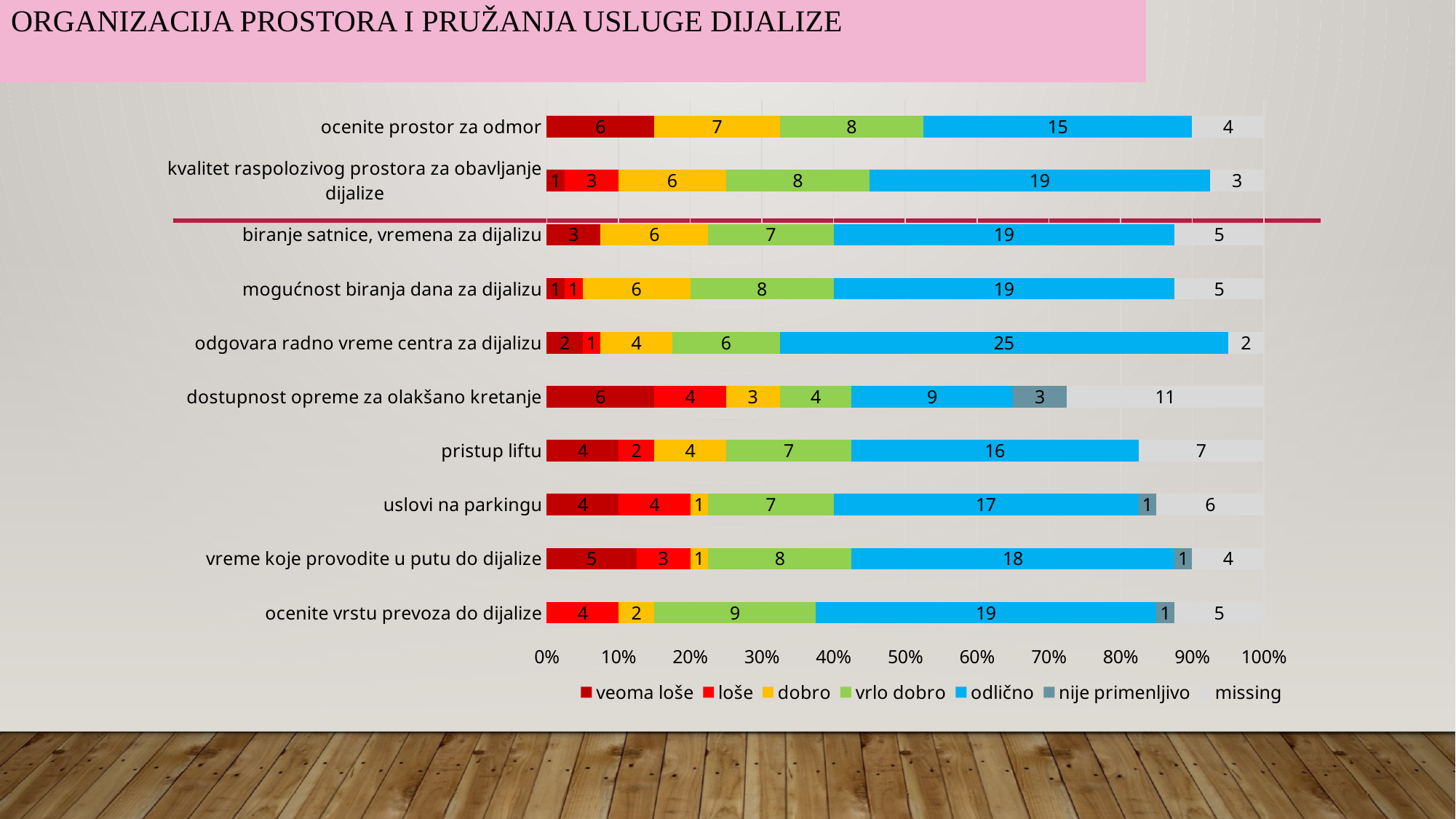
How many categories (rows) are plotted in the chart? 10 What is the 'odlično' value for 'odgovara radno vreme centra za dijalizu'? 25 What is the total of all segments in the bar for 'uslovi na parkingu'? 40 What is the difference between the 'odlično' values for 'odgovara radno vreme centra za dijalizu' and 'pristup liftu'? 9 What is the 'veoma loše' value for 'ocenite prostor za odmor'? 6 Which is larger: the 'vrlo dobro' value for 'ocenite vrstu prevoza do dijalize' or for 'pristup liftu'? ocenite vrstu prevoza do dijalize What is the title of the slide containing the chart? ORGANIZACIJA PROSTORA I PRUŽANJA USLUGE DIJALIZE What type of chart is shown on the slide? stacked bar chart Which category has the lowest 'odlično' value? dostupnost opreme za olakšano kretanje What is the 'missing' value for 'dostupnost opreme za olakšano kretanje'? 11 How many series does the legend list? 7 Which category has the highest 'odlično' value? odgovara radno vreme centra za dijalizu